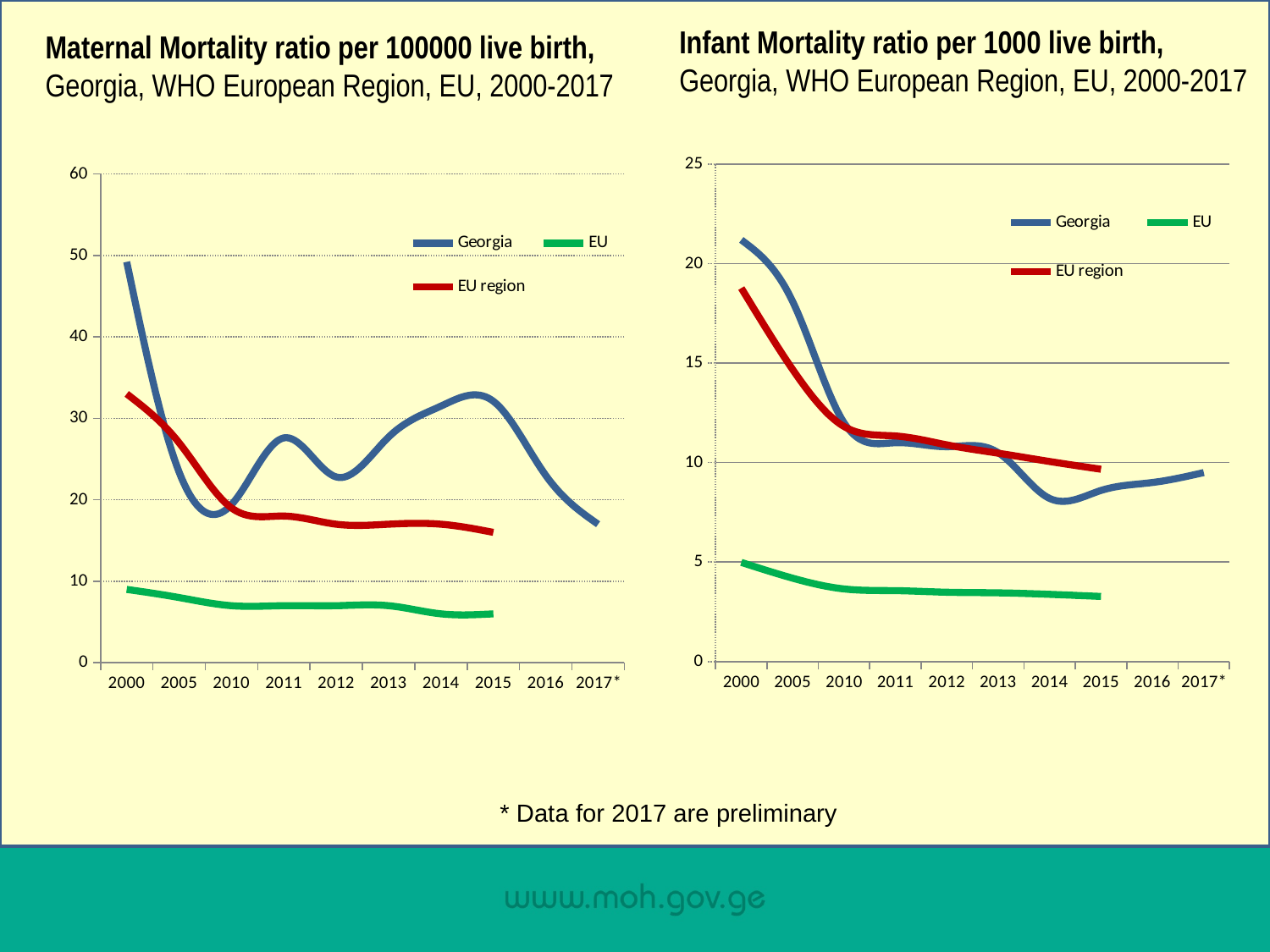
How many years are labelled on the x axis of the Maternal Mortality chart on the left? 10 In the Infant Mortality chart on the right, does the Georgia line overall rise or fall from 2000 to 2017*? fall In the Maternal Mortality chart on the left, is the value for Georgia in 2000 greater or less than 40? greater In the Infant Mortality chart on the right, is the value for EU in 2015 greater or less than 5? less How many series does the legend of the Infant Mortality chart on the right list? 3 In the Infant Mortality chart on the right, is the value for Georgia in 2000 greater or less than 20? greater What kind of chart is the Maternal Mortality chart on the left? line chart In the Maternal Mortality chart on the left, which is larger in 2000, Georgia or EU region? Georgia Which series is drawn in red in both charts? EU region